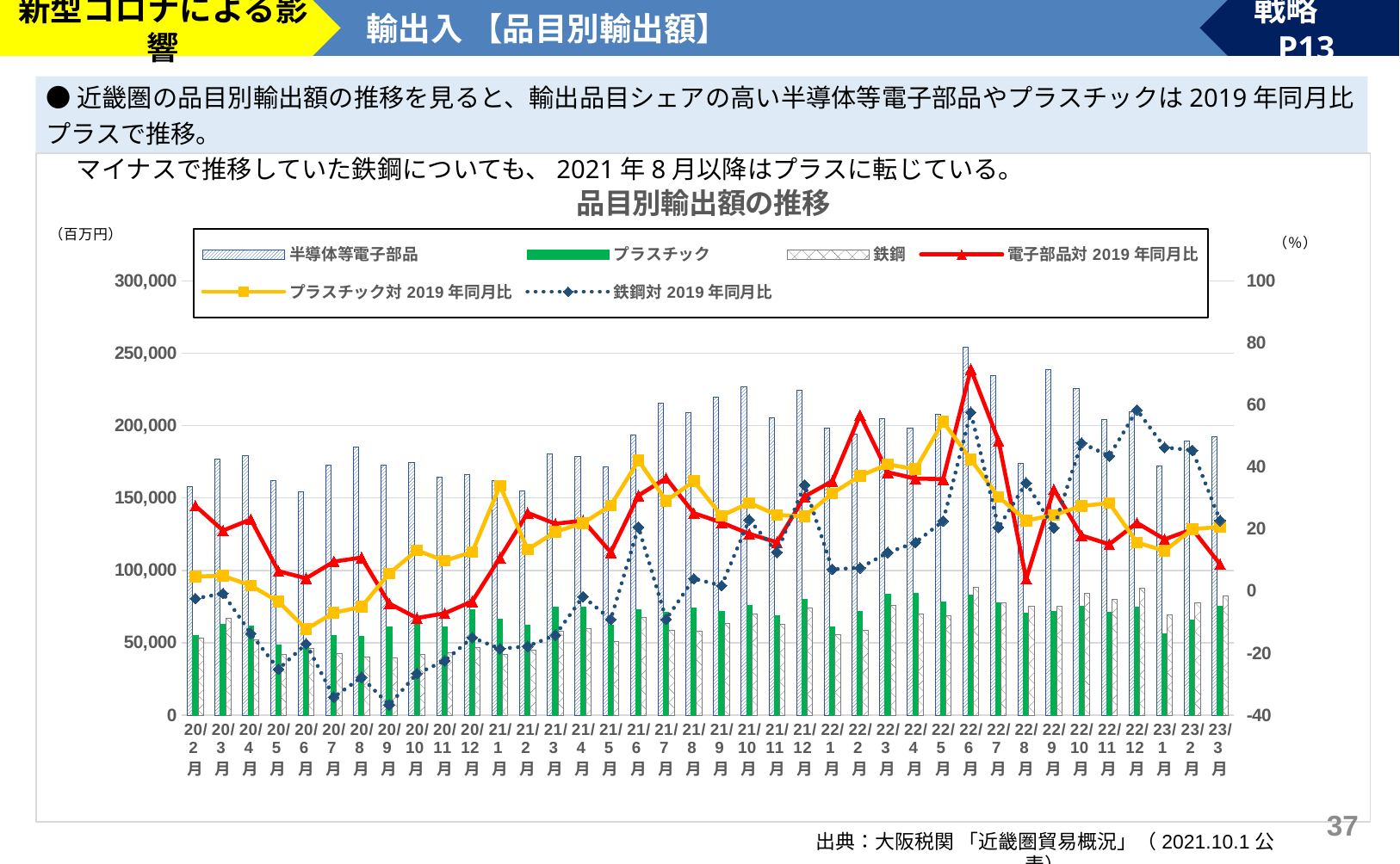
What is the title of the chart? 品目別輸出額の推移 In which month does the 電子部品対2019年同月比 line reach its highest point? 22/6月 How many series does the legend list? 6 How many months are shown along the x axis? 38 Is the 鉄鋼対2019年同月比 value for 20/9月 greater or less than -20? less In which month is the 半導体等電子部品 bar the highest? 22/6月 Is the プラスチック value for 20/2月 greater or less than 100,000? less In which month does the 鉄鋼対2019年同月比 line reach its lowest point? 20/9月 What unit is shown for the left vertical axis? 百万円 What kind of chart is shown on the slide? A combination bar and line chart Is the 半導体等電子部品 value for 22/6月 greater or less than 200,000? greater